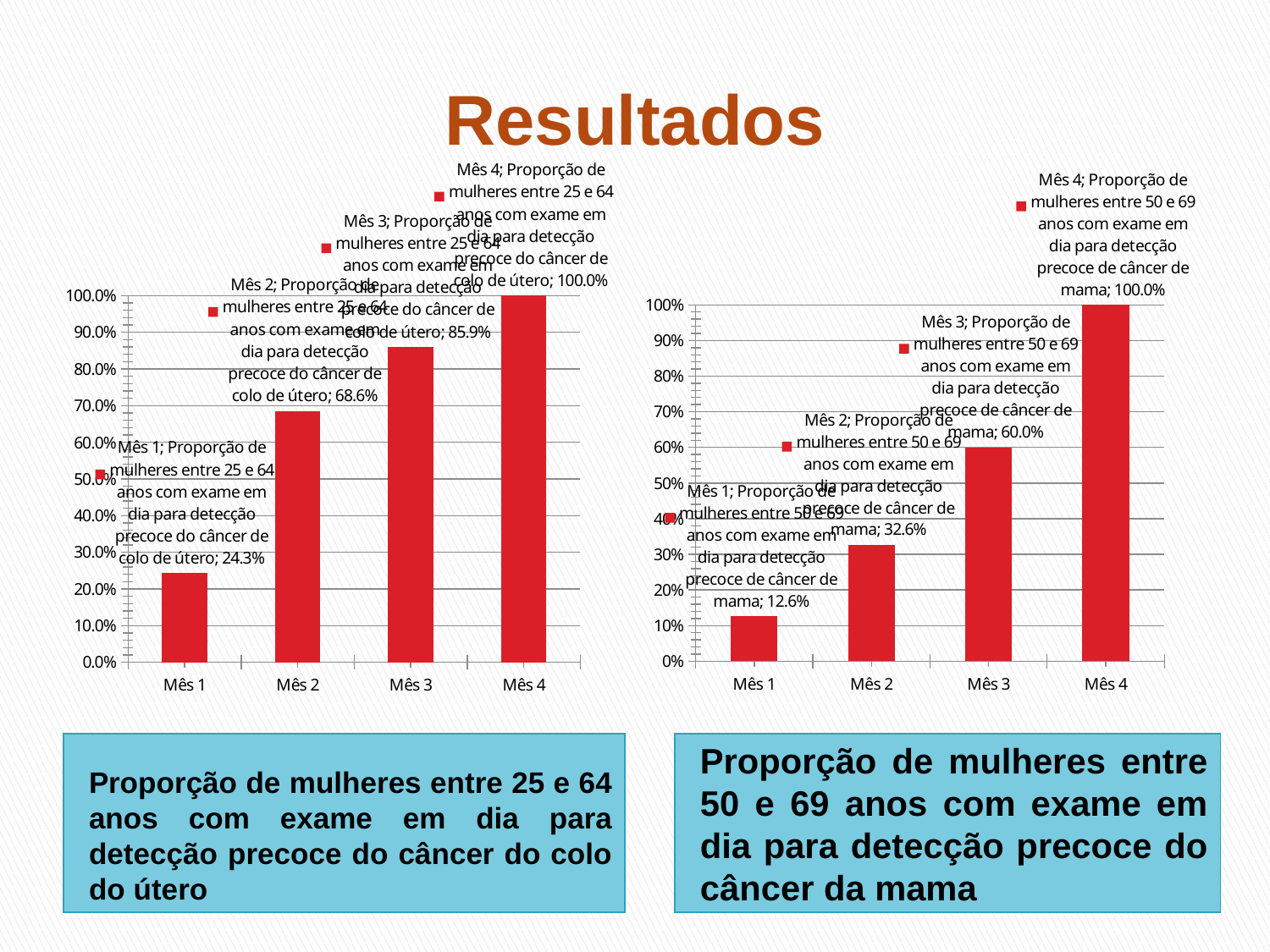
In the left chart (women aged 25 to 64, cervical cancer screening), what is the value for Mês 1? 24.3% In the left chart (women aged 25 to 64), which month has the lowest value? Mês 1 Which is larger: the Mês 2 value in the left chart or the Mês 2 value in the right chart? The left chart (68.6%) In the right chart (women aged 50 to 69), do the values rise or fall from Mês 1 to Mês 4? Rise What type of chart is the left chart (women aged 25 to 64)? Bar chart In the right chart (women aged 50 to 69, breast cancer screening), what is the value for Mês 2? 32.6% In the right chart (women aged 50 to 69, breast cancer screening), what is the value for Mês 3? 60.0% How many months are shown on the x axis of the right chart (women aged 50 to 69)? 4 In the right chart (women aged 50 to 69), which month has the highest value? Mês 4 In the left chart (women aged 25 to 64), what is the difference between the values for Mês 2 and Mês 1? 44.3% In the left chart (women aged 25 to 64, cervical cancer screening), what is the value for Mês 3? 85.9% In the right chart (women aged 50 to 69), what is the difference between the values for Mês 4 and Mês 3? 40.0%